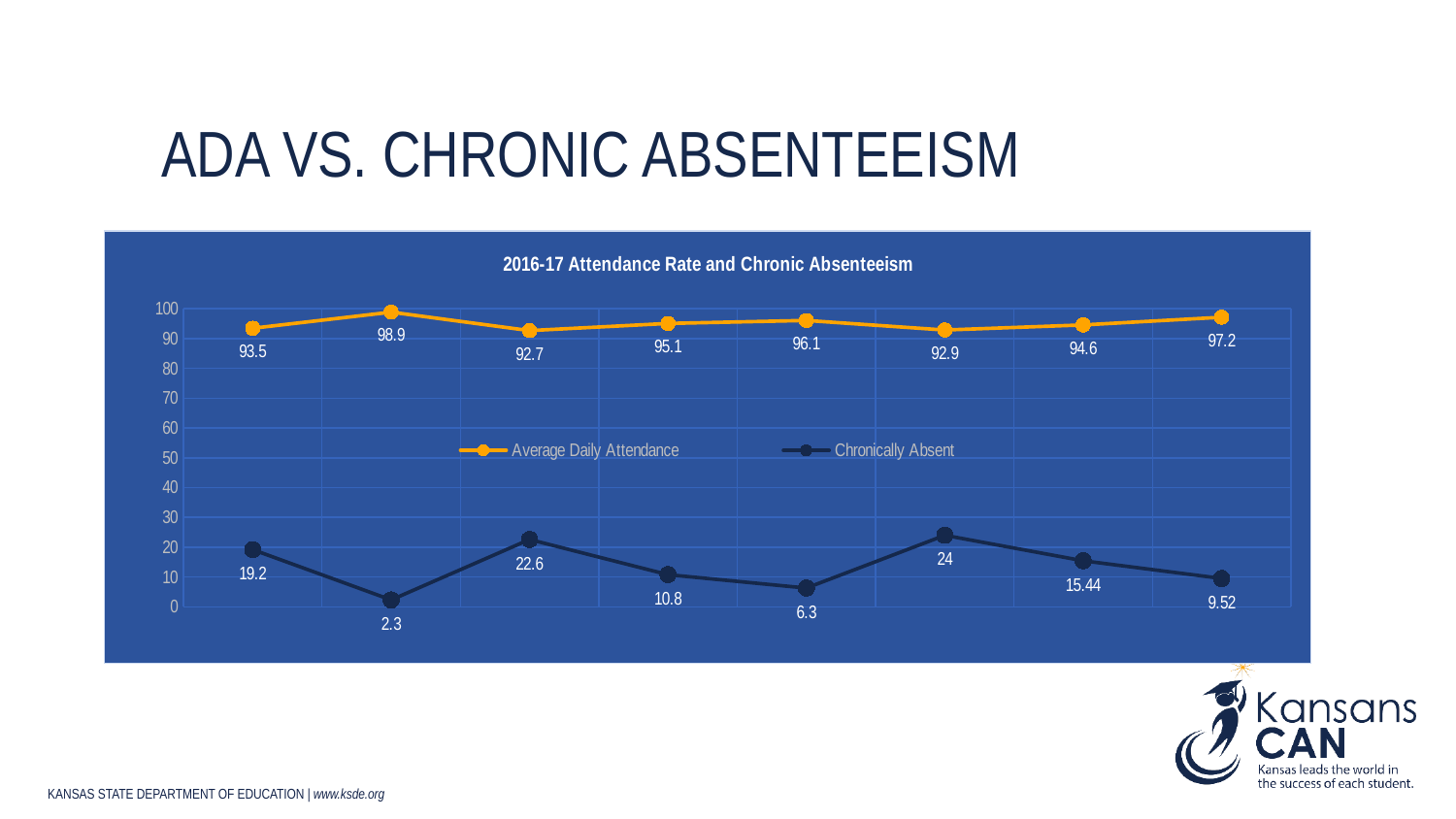
What is the Average Daily Attendance value at the first (leftmost) point? 93.5 What is the lowest value on the Average Daily Attendance line? 92.7 What is the Chronically Absent value at the last (rightmost) point? 9.52 What is the title of the chart? 2016-17 Attendance Rate and Chronic Absenteeism What type of chart is shown on the slide? Line chart What is the difference between the highest and lowest Chronically Absent values? 21.7 What is the highest value on the Average Daily Attendance line? 98.9 What is the lowest value on the Chronically Absent line? 2.3 What is the difference between the highest and lowest Average Daily Attendance values? 6.2 How many series does the chart's legend list? 2 How many data points does the Average Daily Attendance line have? 8 What is the highest value on the Chronically Absent line? 24